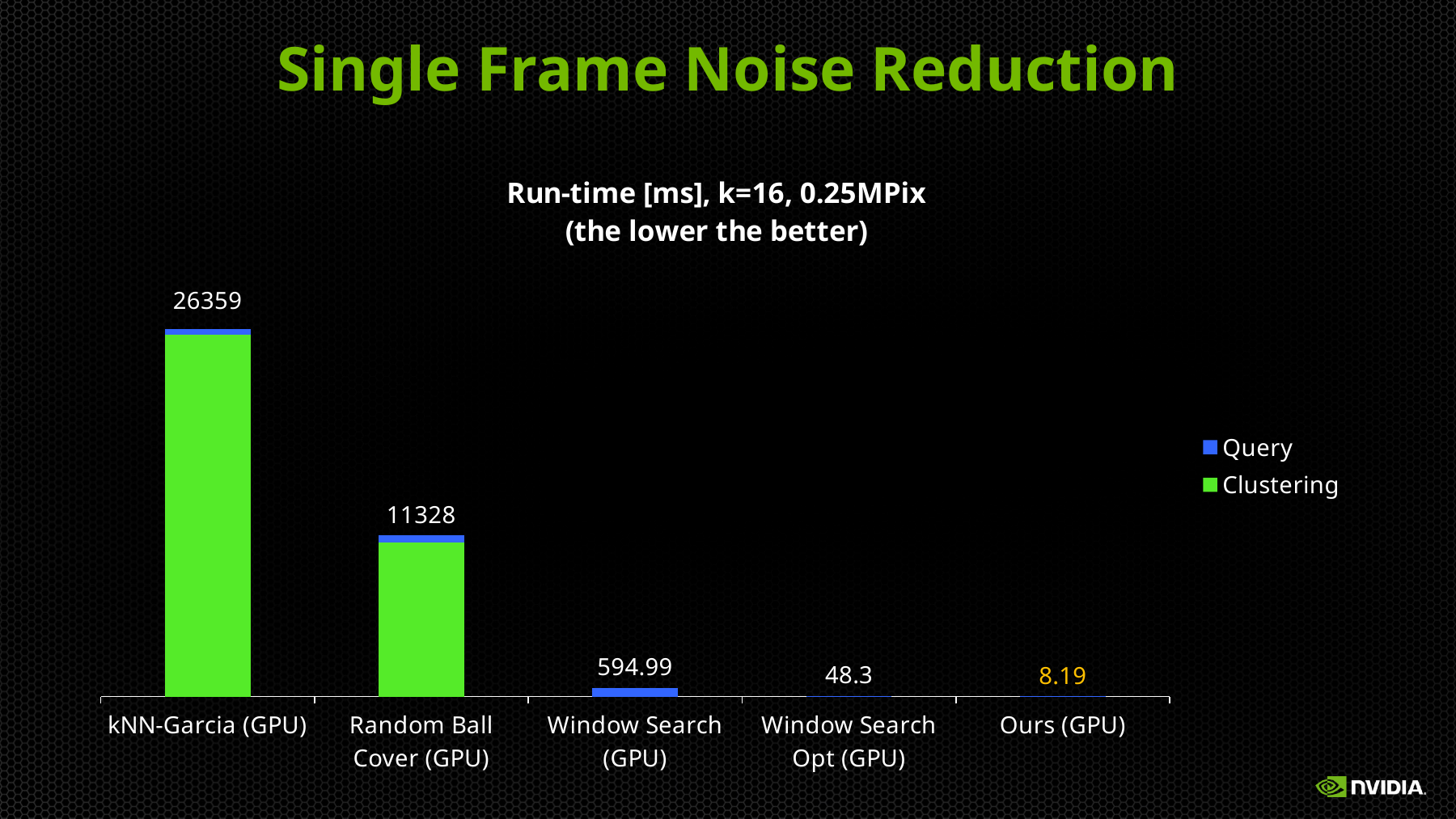
Which has a larger run-time, Window Search (GPU) or Window Search Opt (GPU)? Window Search (GPU) What is the run-time value shown for Window Search Opt (GPU)? 48.3 What is the difference in run-time between kNN-Garcia (GPU) and Random Ball Cover (GPU)? 15031 What is the run-time value shown for Random Ball Cover (GPU)? 11328 What is the run-time value shown for Window Search (GPU)? 594.99 What is the run-time value shown for Ours (GPU)? 8.19 Which method has the lowest run-time in the chart? Ours (GPU) What type of chart is shown on the slide? Bar chart How many series does the chart legend list? 2 Which method has the highest run-time in the chart? kNN-Garcia (GPU) What is the run-time value shown for kNN-Garcia (GPU)? 26359 How many methods are compared on the x axis of the chart? 5